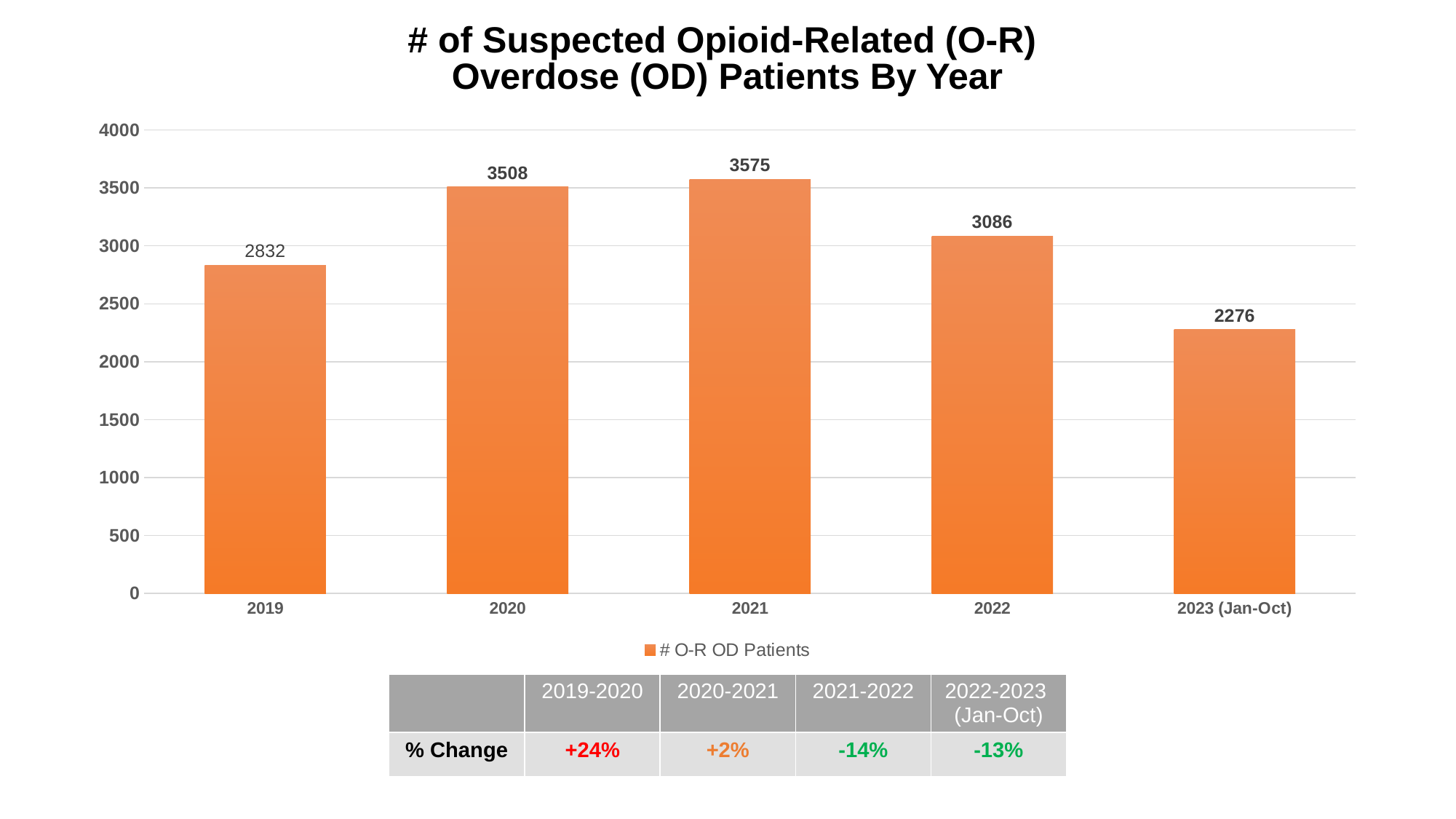
Which year has more O-R OD patients, 2022 or 2019? 2022 What is the legend entry for the series shown? # O-R OD Patients What is the number of O-R OD patients for 2021? 3575 Which year has the highest number of O-R OD patients? 2021 Which category has the lowest number of O-R OD patients? 2023 (Jan-Oct) What is the number of O-R OD patients for 2019? 2832 What is the difference between the number of O-R OD patients in 2020 and in 2019? 676 What kind of chart is shown on the slide? bar chart How many series does the legend list? 1 What is the number of O-R OD patients for 2023 (Jan-Oct)? 2276 How many categories are shown on the x axis? 5 Is the value for 2022 greater or less than 3000? greater